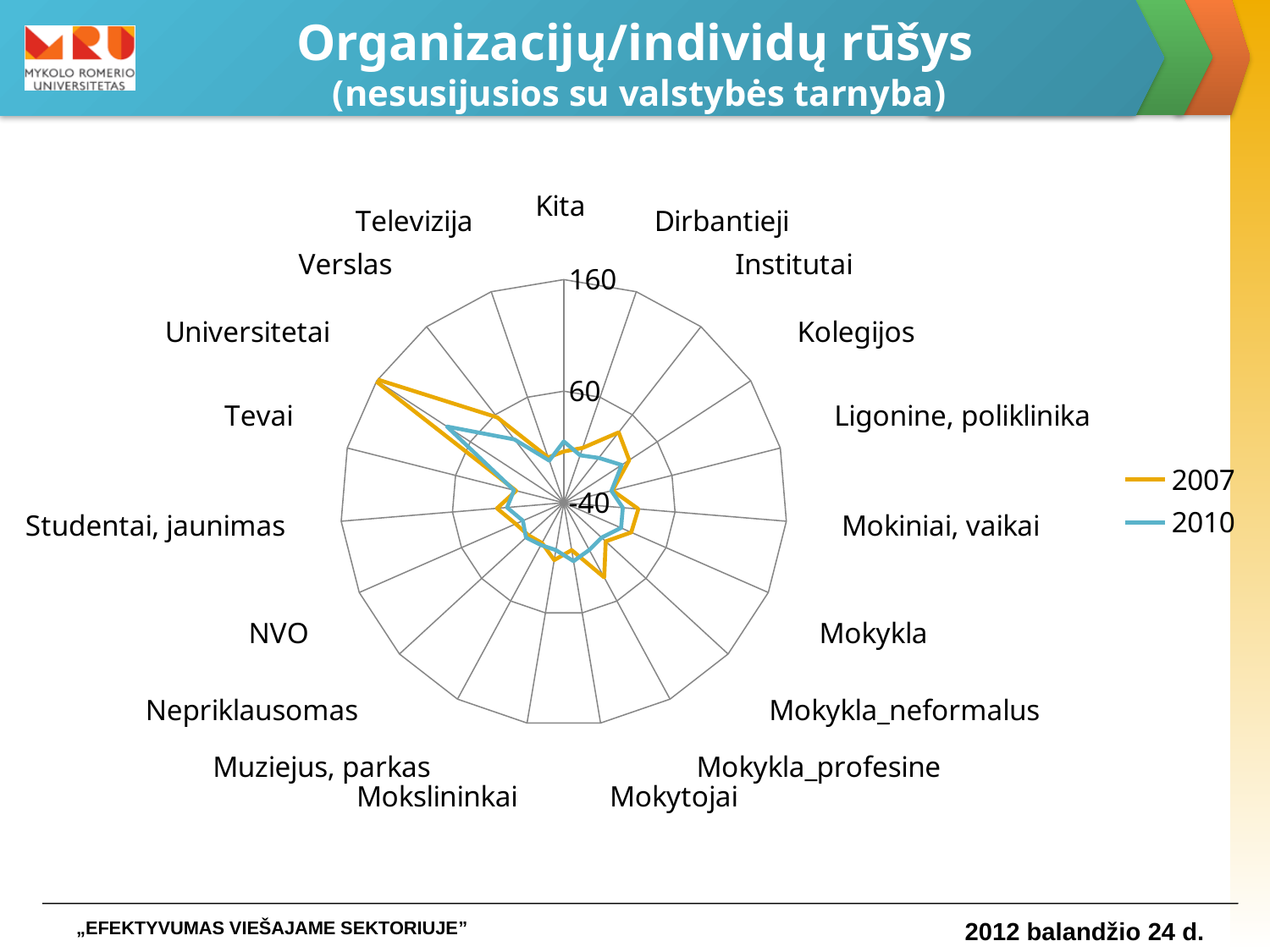
What kind of chart is shown on the slide? radar chart Which colour represents the 2010 series? blue What is the highest value shown on the chart's axis scale? 160 Which category has the highest value for the 2010 series? Universitetai Which years are listed in the chart legend? 2007 and 2010 How many series does the legend list? 2 Is the 2010 value for Studentai, jaunimas greater or less than 60? less Which category has the highest value for the 2007 series? Universitetai Is the 2007 value for Kita greater or less than 60? less Is the 2007 value for Universitetai greater or less than 60? greater For Universitetai, which series has the larger value, 2007 or 2010? 2007